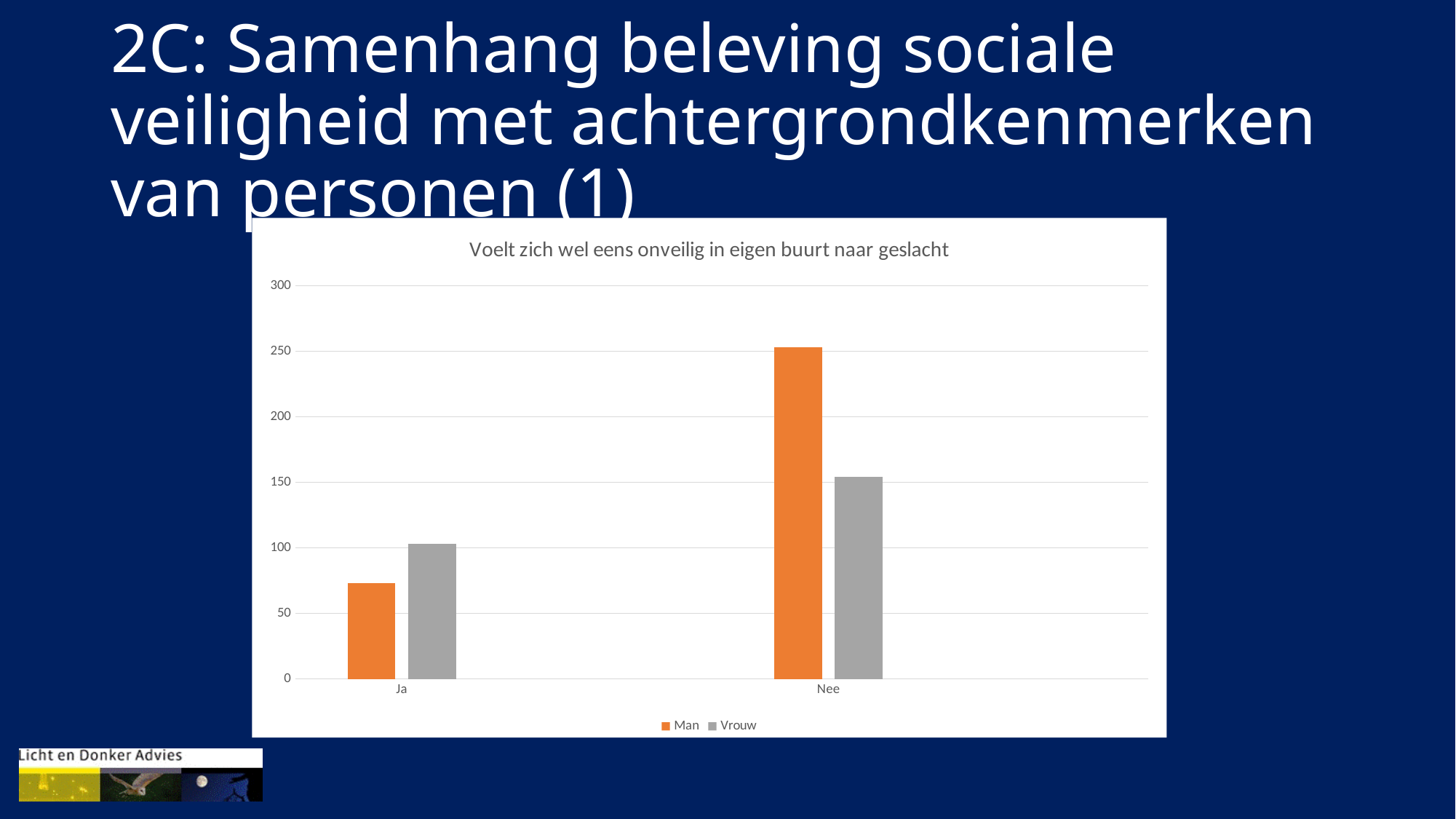
For the category Nee, which is larger: Man or Vrouw? Man Is the value for Vrouw in the category Nee greater or less than 200? less Which series is shown in orange? Man Is the value for Man in the category Nee greater or less than 200? greater How many series does the legend list? 2 What is the title of the chart? Voelt zich wel eens onveilig in eigen buurt naar geslacht What kind of chart is shown on the slide? bar chart For the category Ja, which is larger: Man or Vrouw? Vrouw Which bar is the tallest in the chart? Man, Nee How many categories are shown on the x axis? 2 Is the value for Man in the category Ja greater or less than 100? less Which bar is the shortest in the chart? Man, Ja